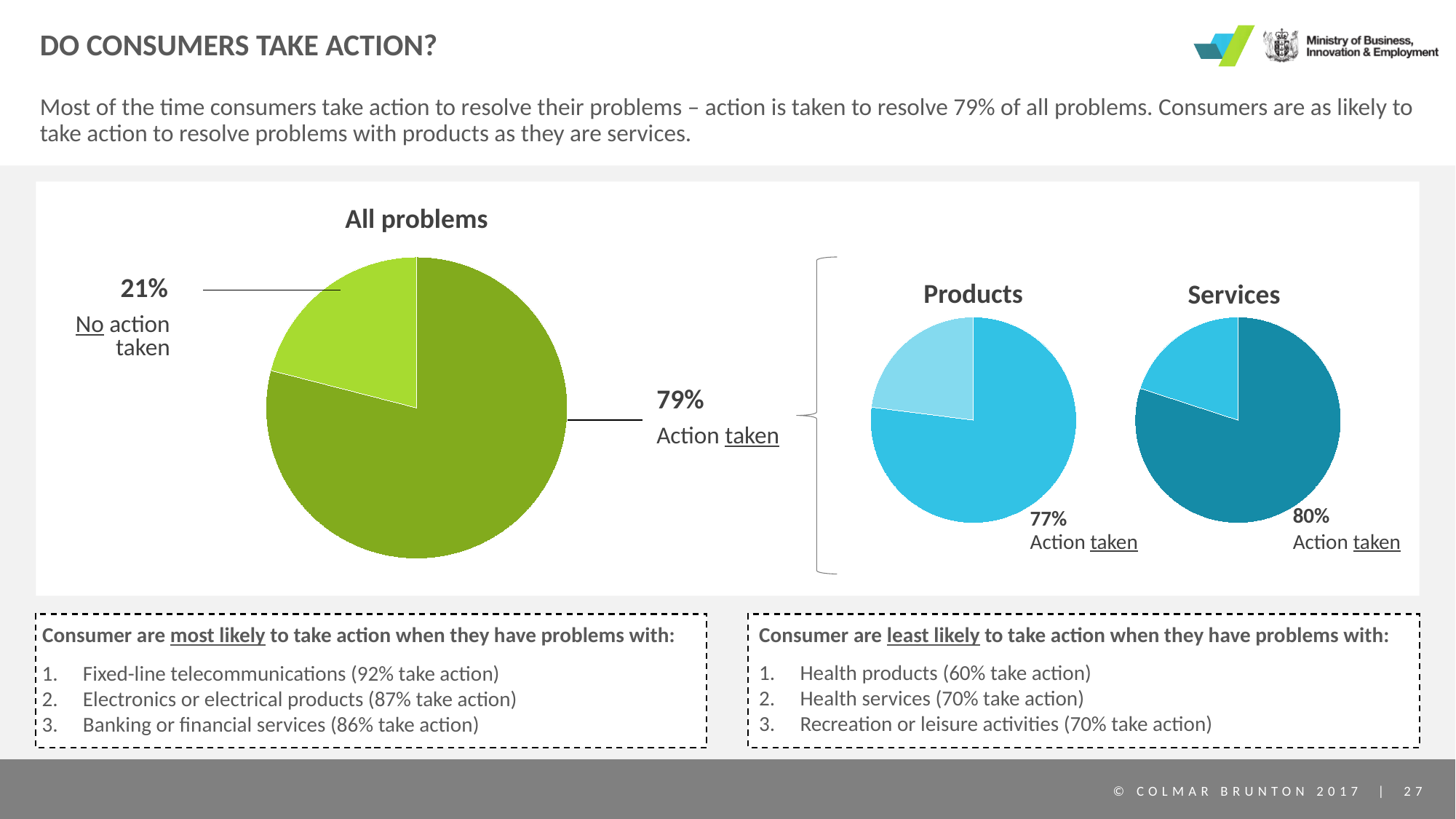
In the 'All problems' pie chart, which slice is the smallest? No action taken In the 'All problems' pie chart, what is the difference between the 'Action taken' and 'No action taken' shares? 58 percentage points In the 'All problems' pie chart, what share of problems had action taken? 79% In the 'Products' pie chart, what percentage of problems had action taken? 77% In the 'Services' pie chart, what percentage of problems had action taken? 80% Which pie chart shows a higher share of action taken: 'Products' or 'Services'? Services What is the title of the pie chart on the left of the slide? All problems In the 'All problems' pie chart, what share of problems had no action taken? 21% How many pie charts are shown on the slide? 3 What kind of chart is the 'All problems' chart? Pie chart What is the difference in percentage points between the 'Action taken' share in the 'Services' chart and the 'Products' chart? 3 percentage points In the 'All problems' pie chart, which slice is larger: 'Action taken' or 'No action taken'? Action taken